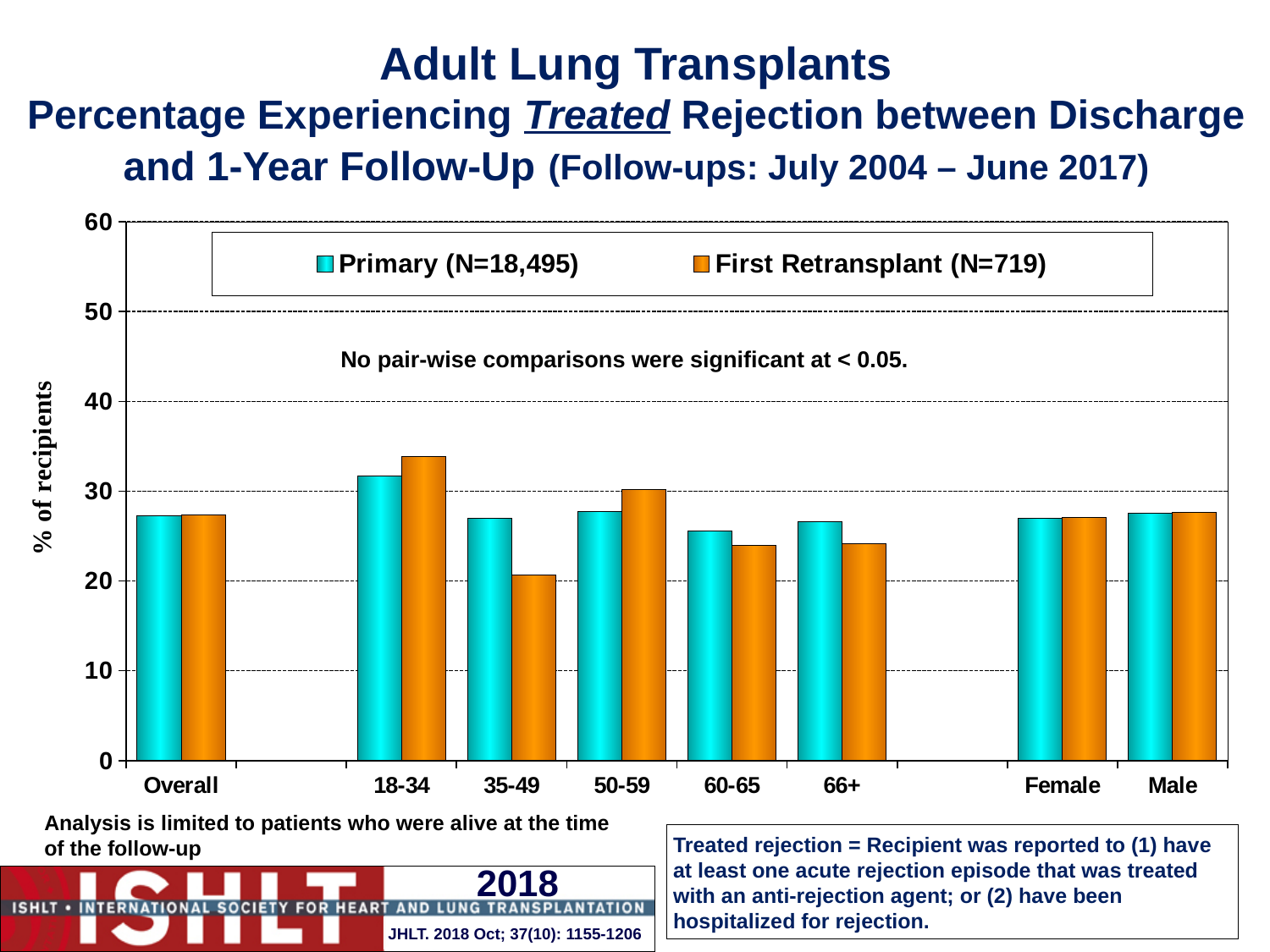
Is the value for First Retransplant (N=719) in the 35-49 group greater or less than 30? less What kind of chart is shown on the slide? bar chart Which category has the highest value for Primary (N=18,495)? 18-34 How many series does the legend list? 2 In the 35-49 group, which series has the larger value, Primary (N=18,495) or First Retransplant (N=719)? Primary (N=18,495) In the 18-34 group, which series has the larger value, Primary (N=18,495) or First Retransplant (N=719)? First Retransplant (N=719) What is the label of the y axis? % of recipients Is the value for Primary (N=18,495) in the 60-65 group greater or less than 30? less Which category has the highest value for First Retransplant (N=719)? 18-34 Which category has the lowest value for First Retransplant (N=719)? 35-49 How many categories are shown along the x axis? 8 Is the value for First Retransplant (N=719) in the 18-34 group greater or less than 30? greater